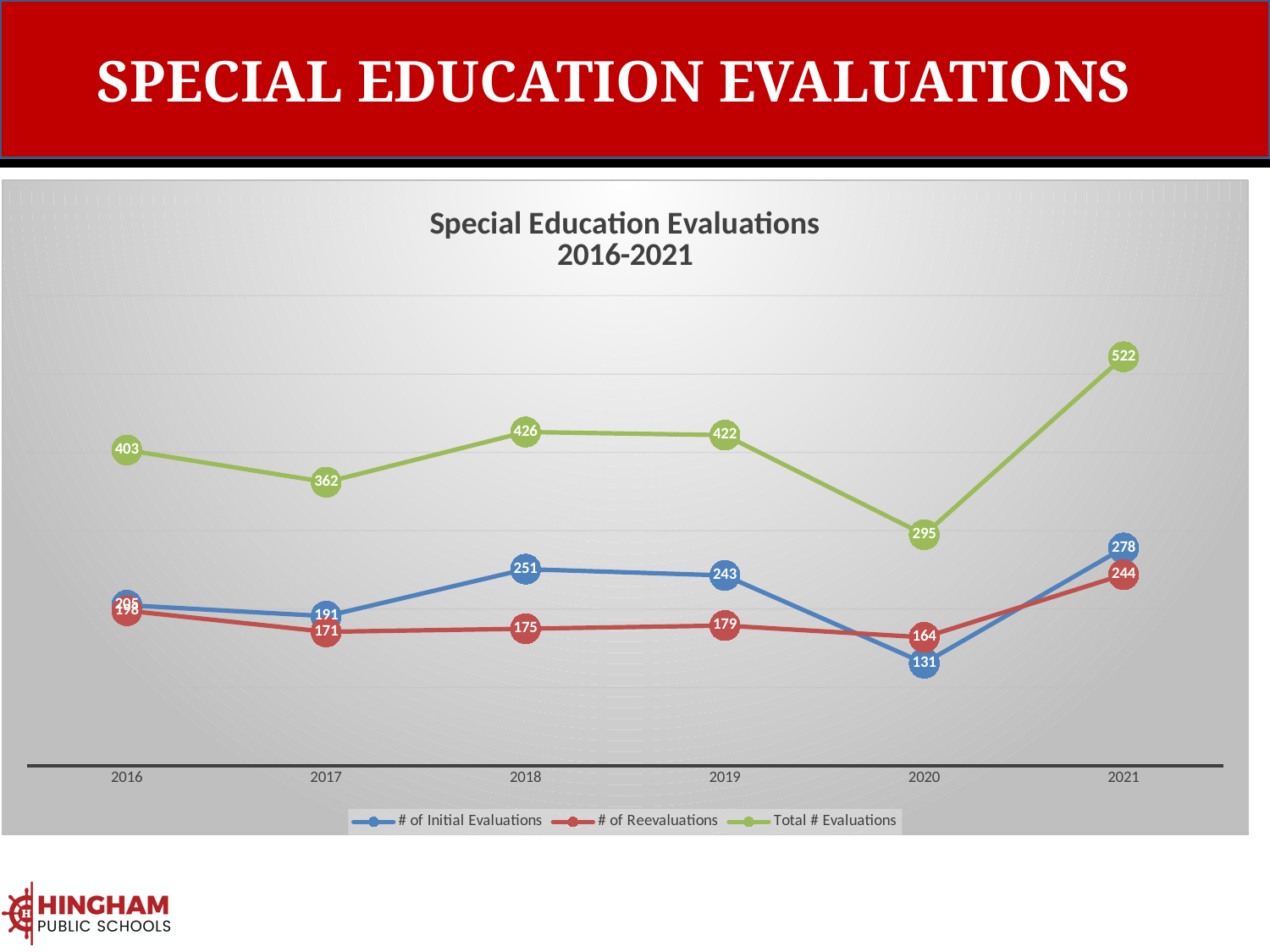
How many series does the legend list? 3 What is the difference between the Total # Evaluations in 2021 and in 2020? 227 In which year was the # of Initial Evaluations highest? 2021 What was the Total # Evaluations in 2021? 522 Did the Total # Evaluations rise or fall from 2019 to 2020? fall What was the # of Initial Evaluations in 2020? 131 What is the title of the chart? Special Education Evaluations 2016-2021 How many years are plotted along the x axis? 6 In which year was the Total # Evaluations lowest? 2020 Which was larger in 2018, the # of Initial Evaluations or the # of Reevaluations? # of Initial Evaluations What kind of chart is shown on the slide? line chart What was the # of Reevaluations in 2019? 179